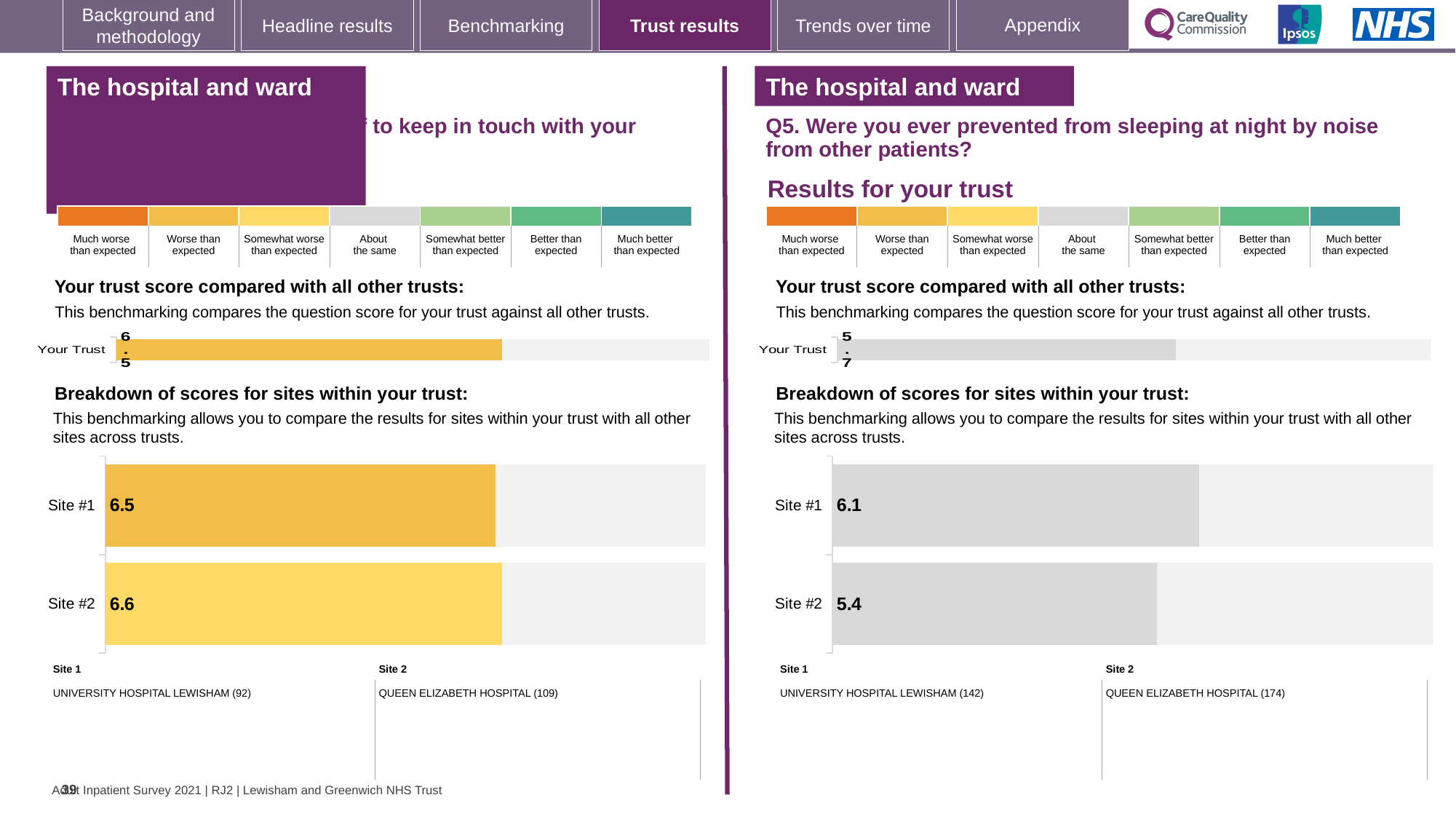
On the right-hand side for Q5, which hospital is listed as Site 2? QUEEN ELIZABETH HOSPITAL (174) On the right-hand chart for Q5, what is the difference between the Site #1 and Site #2 scores? 0.7 On the left-hand site breakdown chart, what is the score for Site #2? 6.6 On the left-hand site breakdown chart, what is the difference between the Site #2 and Site #1 scores? 0.1 On the left-hand side, what is the 'Your Trust' score compared with all other trusts? 6.5 On the left-hand site breakdown chart, what is the score for Site #1? 6.5 On the right-hand chart for Q5, what is the score for Site #2? 5.4 What type of chart is used for the breakdown of scores for sites within your trust? Bar chart On the right-hand chart for Q5 (prevented from sleeping at night by noise from other patients), what is the score for Site #1? 6.1 On the right-hand chart for Q5, which site has the higher score? Site #1 On the right-hand side for Q5, what is the 'Your Trust' score compared with all other trusts? 5.7 How many sites are shown in the site breakdown chart on the right-hand side for Q5? 2